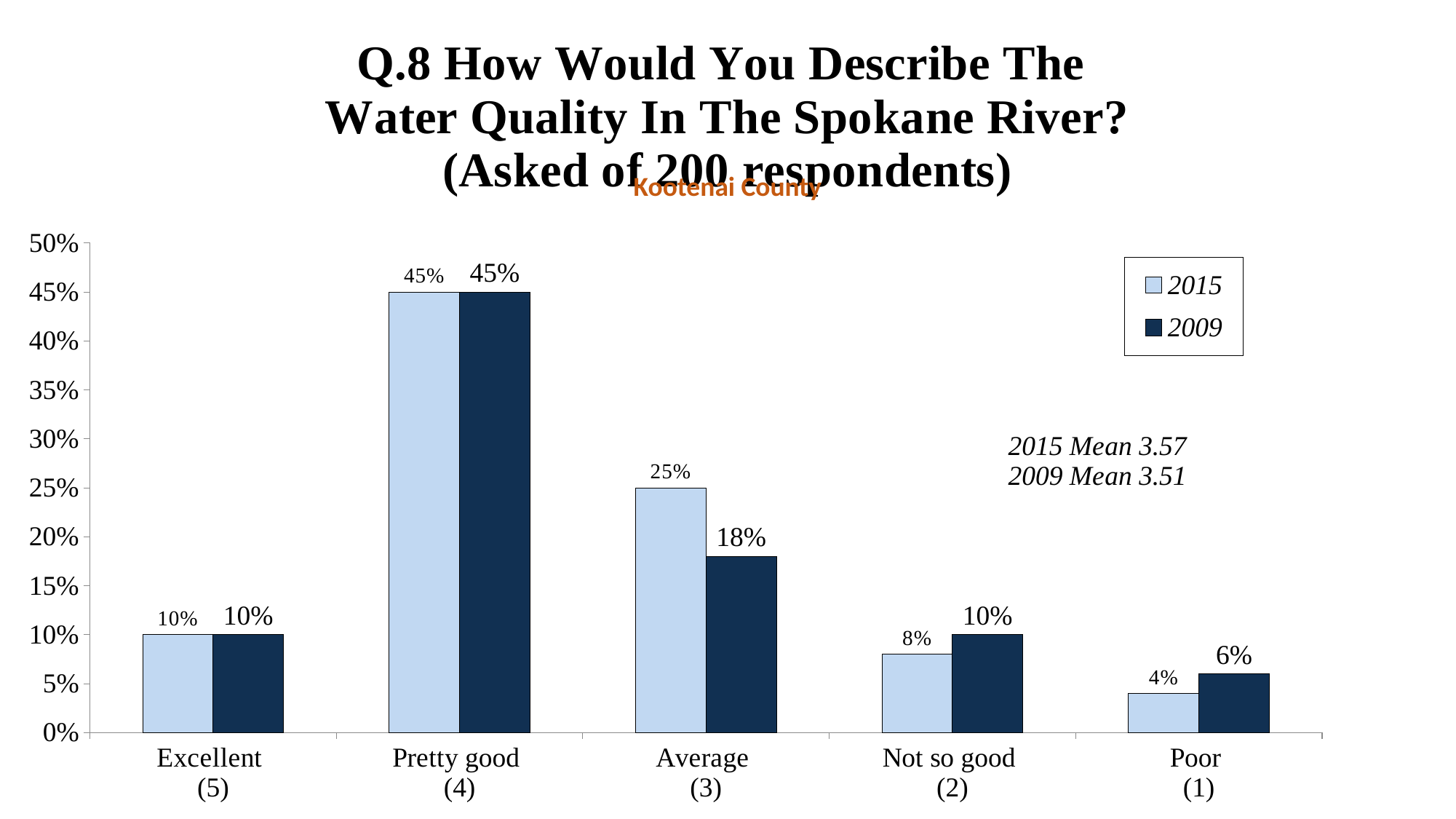
How many response categories are shown on the x axis? 5 What percentage of respondents in 2009 described the water quality as Poor? 6% What percentage of respondents in 2015 described the water quality as Average? 25% What is the 2015 mean shown on the slide? 3.57 How many series does the legend list? 2 What is the 2009 value for Not so good? 10% Which category has the lowest value for the 2015 series? Poor Which is larger for Not so good: the 2015 value or the 2009 value? 2009 What kind of chart is shown on the slide? Bar chart What is the difference between the 2015 and 2009 values for Average? 7% Which category has the highest value for the 2015 series? Pretty good Which series is shown in the darker navy colour? 2009